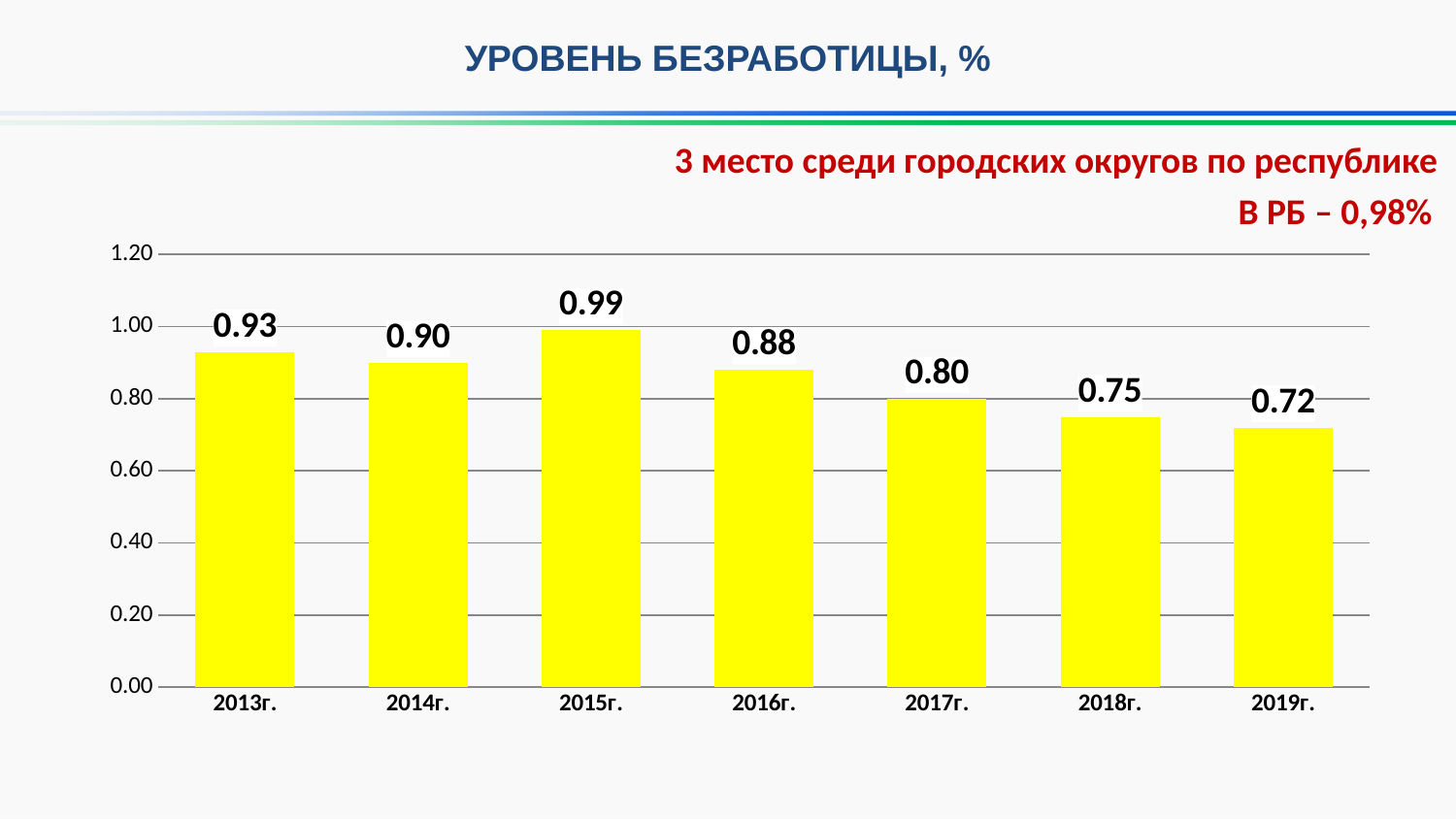
Which year has the highest value on the chart? 2015г. What is the unemployment rate value shown for 2015г.? 0.99 Which year has the lowest value on the chart? 2019г. Is the value for 2015г. greater or less than 0.80? greater Do the values generally rise or fall from 2015г. to 2019г.? fall How many years are shown on the x axis of the chart? 7 What kind of chart is shown on the slide? bar chart What is the difference between the values for 2013г. and 2014г.? 0.03 What is the value shown for 2017г.? 0.80 What is the difference between the values for 2015г. and 2019г.? 0.27 What is the value shown for 2019г.? 0.72 Which is larger, the value for 2016г. or the value for 2018г.? 2016г.